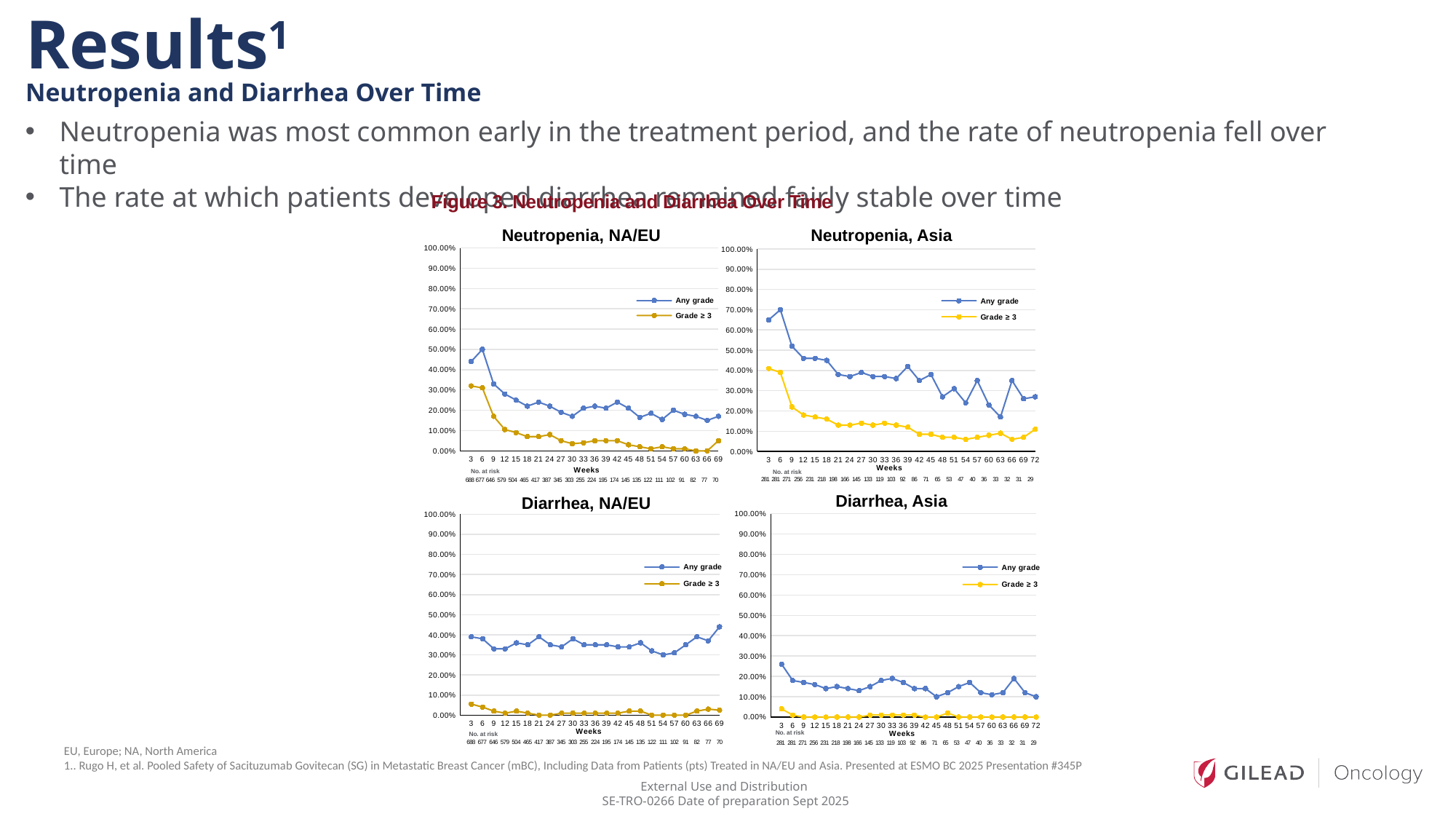
In the Neutropenia, NA/EU chart, does the Any grade series generally rise or fall from week 3 to week 69? Fall In the Neutropenia, NA/EU chart, what is the number at risk at week 3? 688 In the Diarrhea, Asia chart, is the Any grade value at week 3 greater or less than 20.00%? greater What are the two series named in the legend of the Diarrhea, NA/EU chart? Any grade and Grade ≥ 3 How many series does the legend of the Neutropenia, Asia chart list? 2 In the Neutropenia, Asia chart, at which week is the Any grade series highest? Week 6 In the Diarrhea, NA/EU chart, is the Any grade value at week 69 greater or less than 40.00%? greater What kind of chart is the Neutropenia, NA/EU chart? Line chart In the Neutropenia, NA/EU chart, which series is higher at week 3, Any grade or Grade ≥ 3? Any grade How many week time points are plotted on the x axis of the Diarrhea, NA/EU chart? 23 How many week time points are plotted on the x axis of the Neutropenia, Asia chart? 24 In the Neutropenia, Asia chart, is the Any grade value at week 3 greater or less than 60.00%? greater